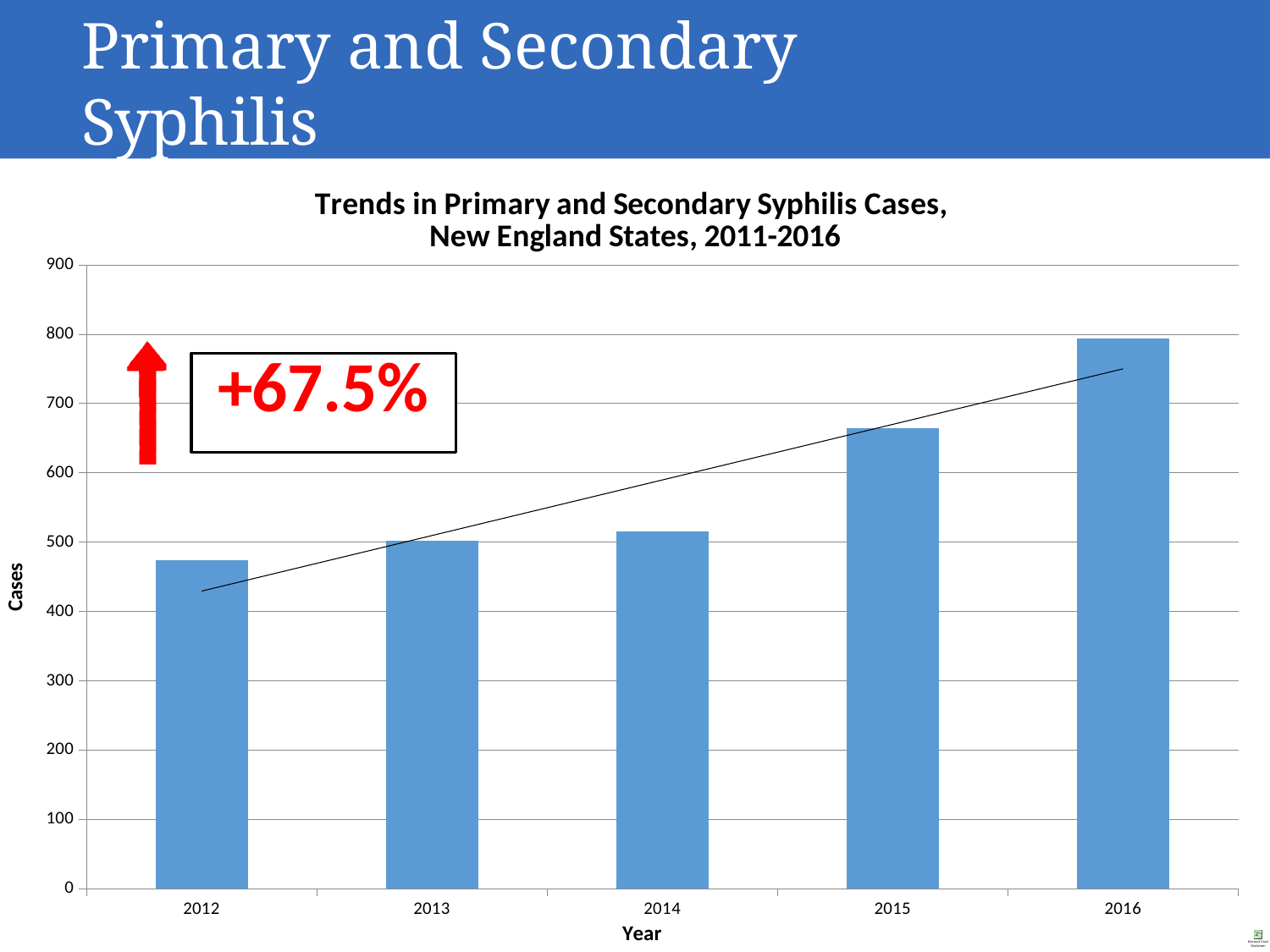
Which year has the lowest number of cases? 2012 Is the value for 2014 greater or less than 600? less Which year has more cases, 2014 or 2015? 2015 What percentage change is shown in the annotation box on the chart? +67.5% How many years are plotted on the x axis of the chart? 5 What kind of chart is shown on the slide? Bar chart Is the value for 2012 greater or less than 500? less Is the value for 2015 greater or less than 600? greater What is the title of the chart? Trends in Primary and Secondary Syphilis Cases, New England States, 2011-2016 Which year has the highest number of cases? 2016 Do the number of cases generally rise or fall from 2012 to 2016? Rise